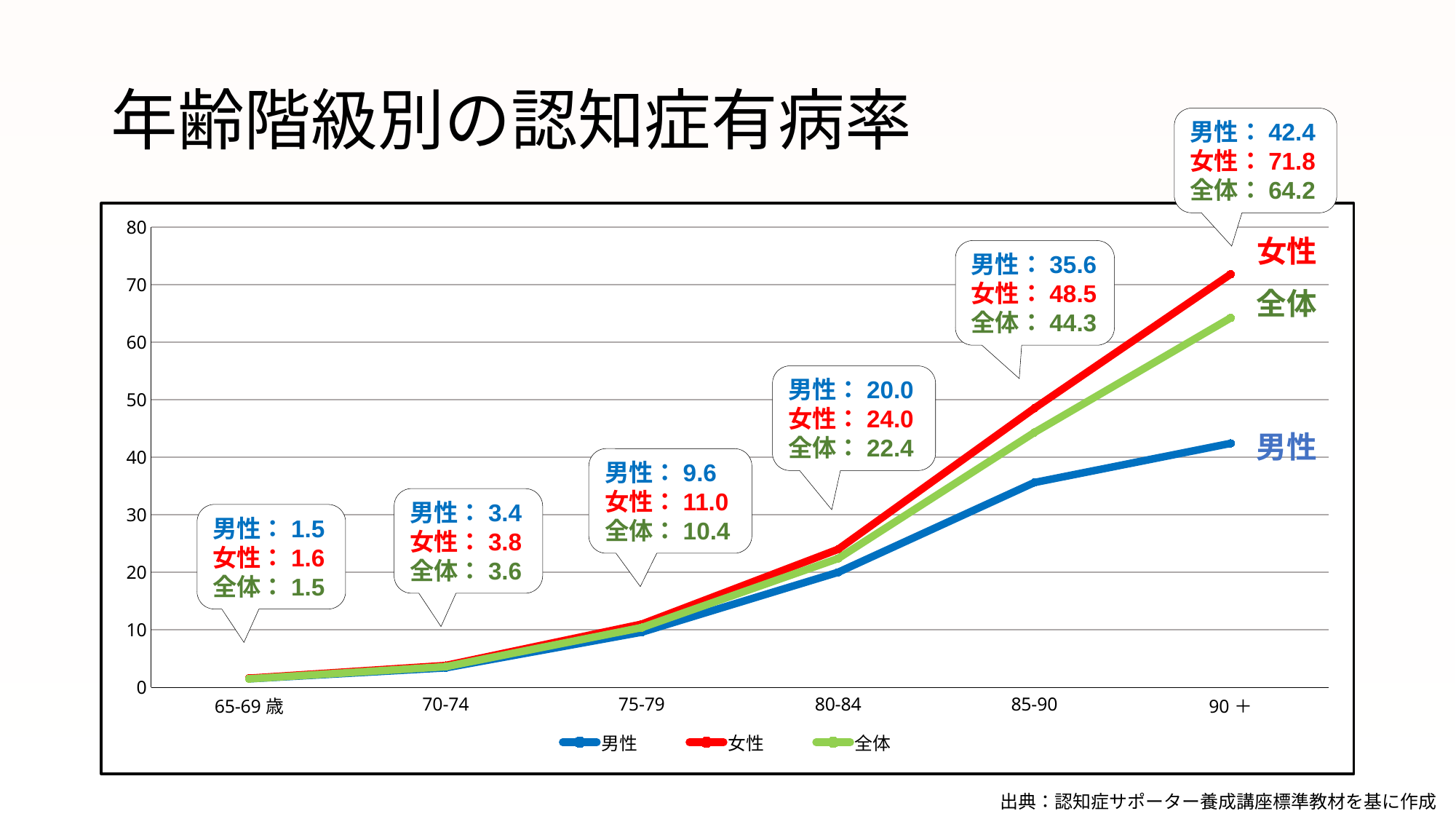
How many age groups are shown on the x axis? 6 What kind of chart is shown on the slide? line chart How many series does the legend list? 3 Do the values for 全体 rise or fall as age increases along the x axis? rise What is the difference between the 女性 and 男性 values in the 85-90 age group? 12.9 Is the value for 全体 in the 85-90 age group greater or less than 40? greater What is the value for 全体 in the 75-79 age group? 10.4 Which age group has the highest value for 女性? 90＋ What is the value for 女性 in the 90＋ age group? 71.8 Which age group has the lowest value for 男性? 65-69 歳 What is the value for 男性 in the 80-84 age group? 20.0 In the 90＋ age group, which is larger: the value for 女性 or the value for 男性? 女性